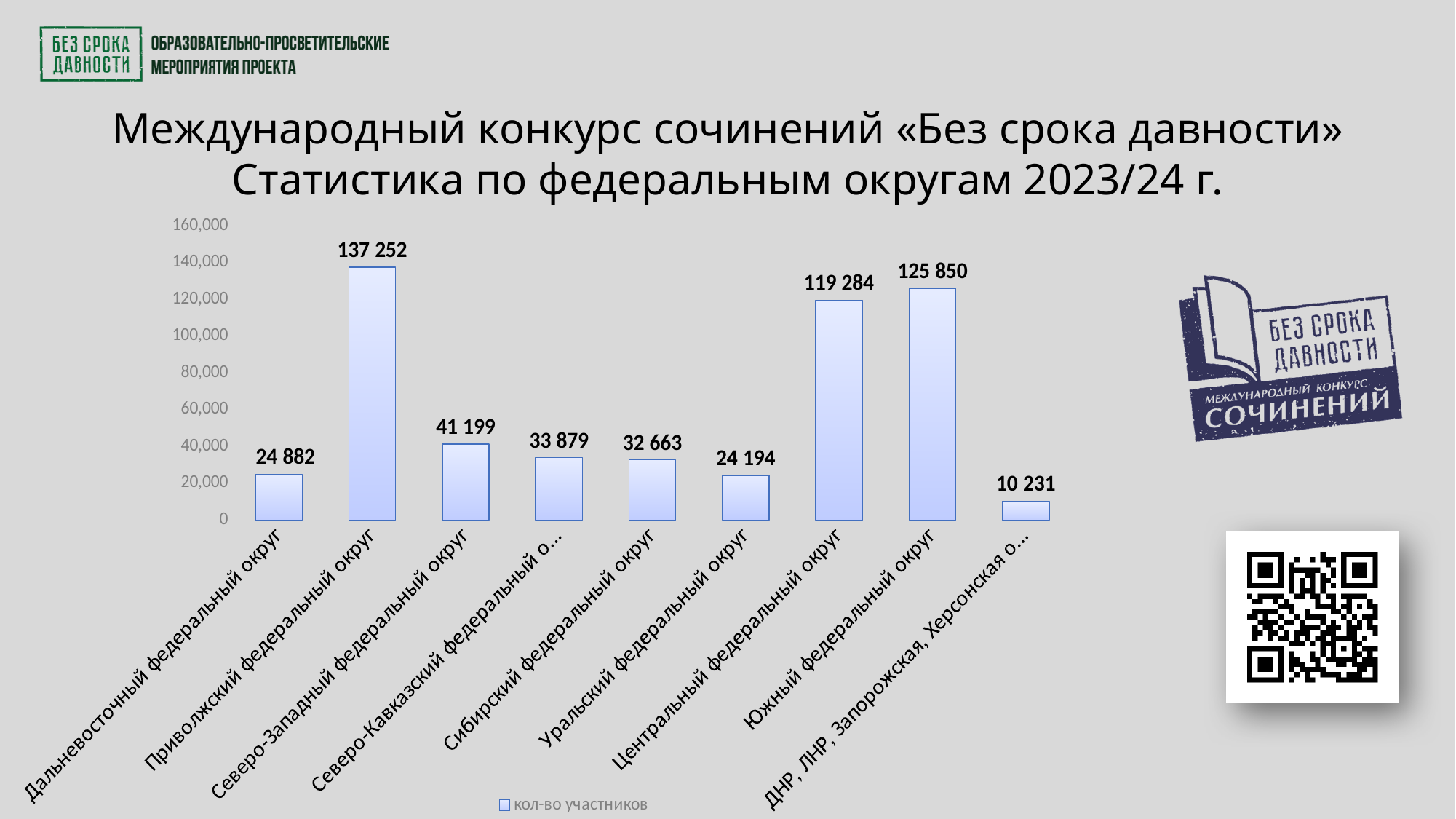
What kind of chart is shown on the slide? bar chart What is the number of participants for Приволжский федеральный округ? 137 252 Which federal district has the highest number of participants? Приволжский федеральный округ Is the value for Центральный федеральный округ greater or less than 100,000? greater What is the difference in participants between Северо-Западный федеральный округ and Дальневосточный федеральный округ? 16 317 What is the difference in participants between Приволжский федеральный округ and Южный федеральный округ? 11 402 Which category has the lowest number of participants? ДНР, ЛНР, Запорожская, Херсонская о... How many categories are shown on the chart? 9 What is the number of participants for Сибирский федеральный округ? 32 663 Which has more participants, Центральный федеральный округ or Южный федеральный округ? Южный федеральный округ What is the number of participants for Южный федеральный округ? 125 850 How many series does the legend list? 1